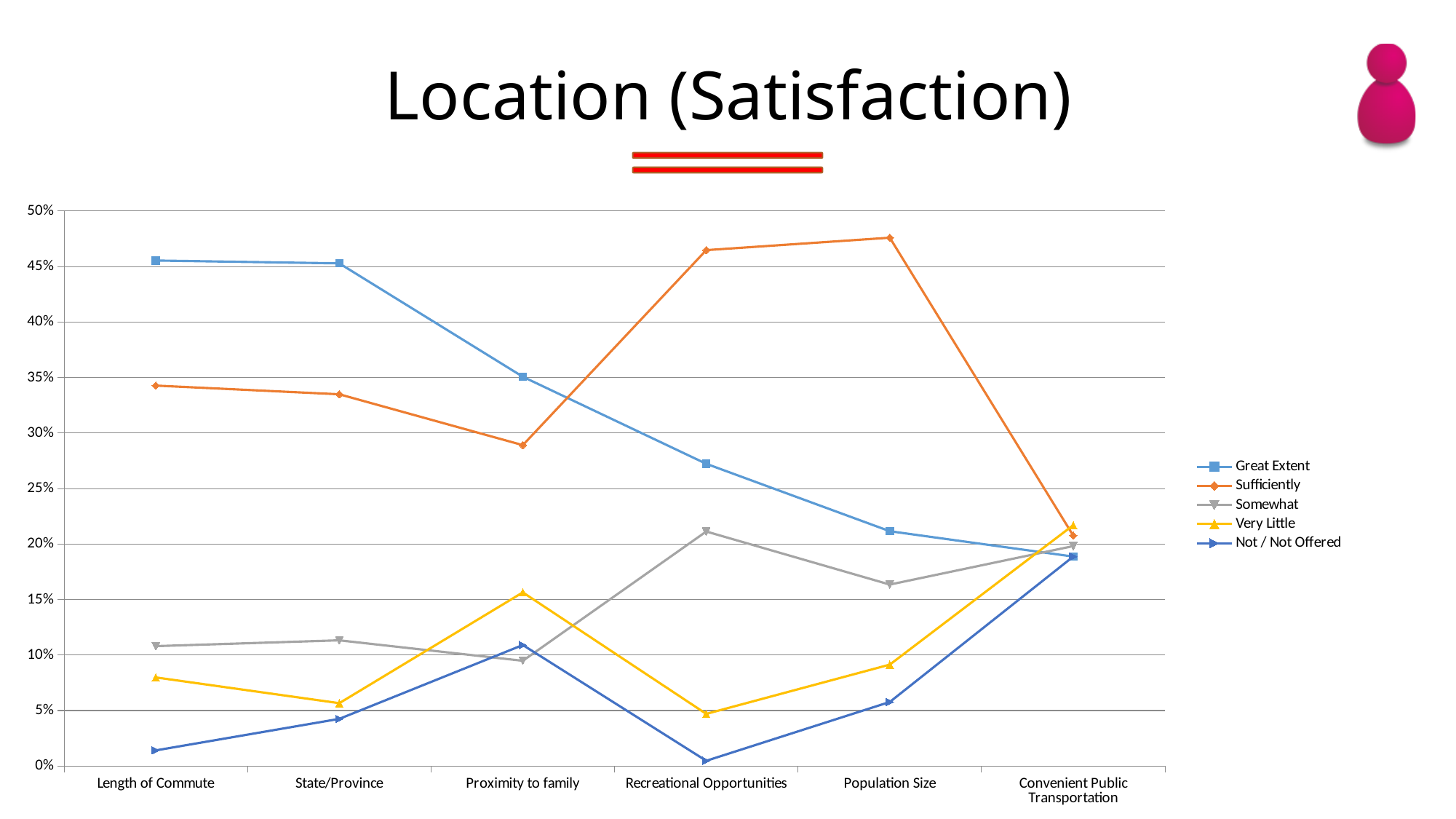
Which category has the lowest value for the Great Extent series? Convenient Public Transportation What kind of chart is shown on the slide? line chart Is the Sufficiently value for Recreational Opportunities greater or less than 45%? greater At Recreational Opportunities, which is larger: Sufficiently or Great Extent? Sufficiently Is the Not / Not Offered value for Length of Commute greater or less than 5%? less How many series does the legend list? 5 How many categories are shown along the x axis? 6 What is the title of the chart? Location (Satisfaction) Is the Great Extent value for Proximity to family greater or less than 30%? greater Which category has the lowest value for the Not / Not Offered series? Recreational Opportunities Which category has the highest value for the Very Little series? Convenient Public Transportation Does the Great Extent series generally rise or fall from Length of Commute to Convenient Public Transportation? fall